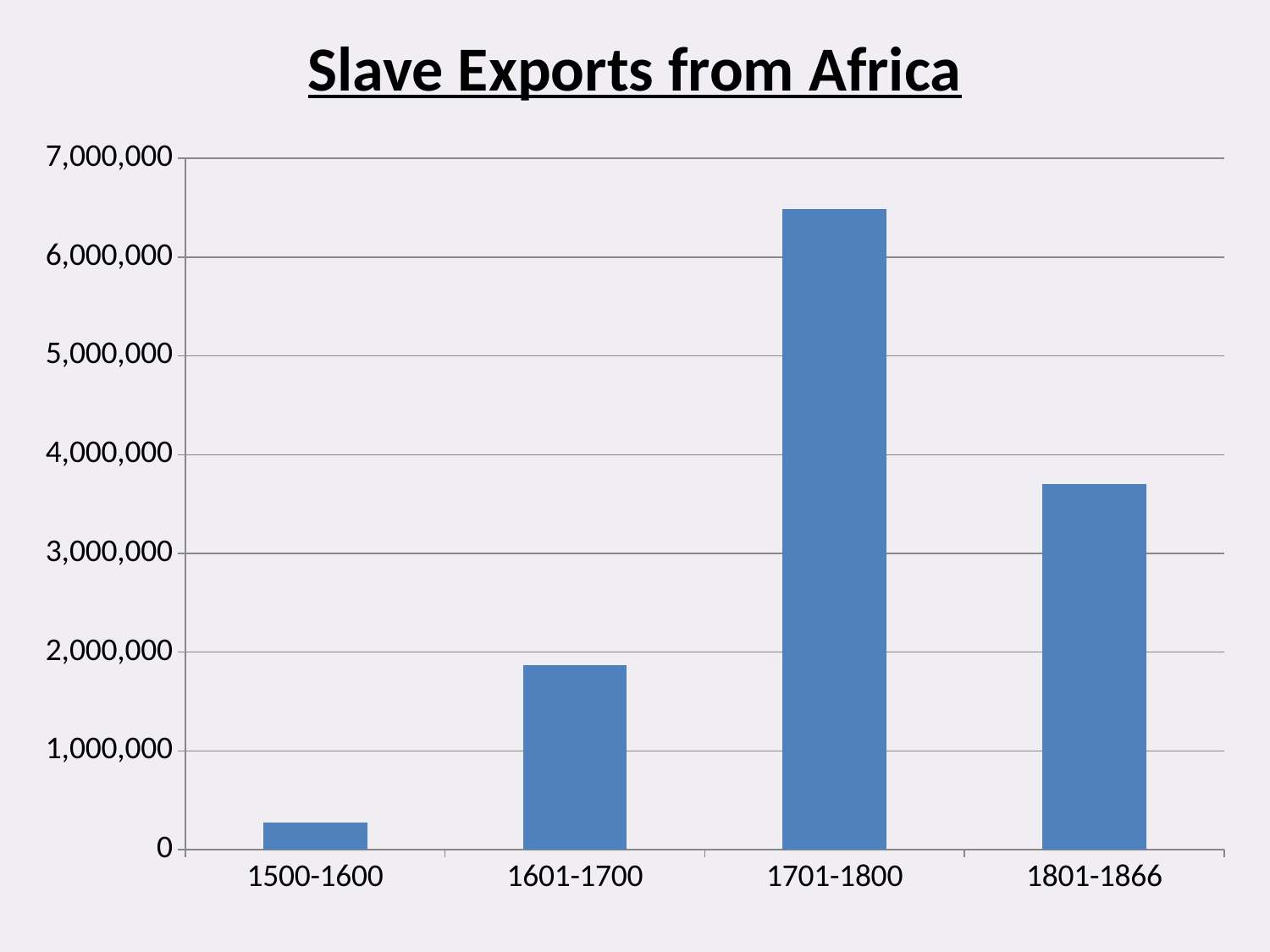
How many time periods are shown on the x axis? 4 Is the value for 1801-1866 greater or less than 4,000,000? less What is the highest value shown on the y axis? 7,000,000 What kind of chart is shown on the slide? bar chart Is the value for 1701-1800 greater or less than 6,000,000? greater What is the title of the chart? Slave Exports from Africa Which period has the lowest value? 1500-1600 Is the value for 1500-1600 greater or less than 1,000,000? less Which is larger, the value for 1500-1600 or the value for 1601-1700? 1601-1700 Which is larger, the value for 1601-1700 or the value for 1801-1866? 1801-1866 Which period has the highest value? 1701-1800